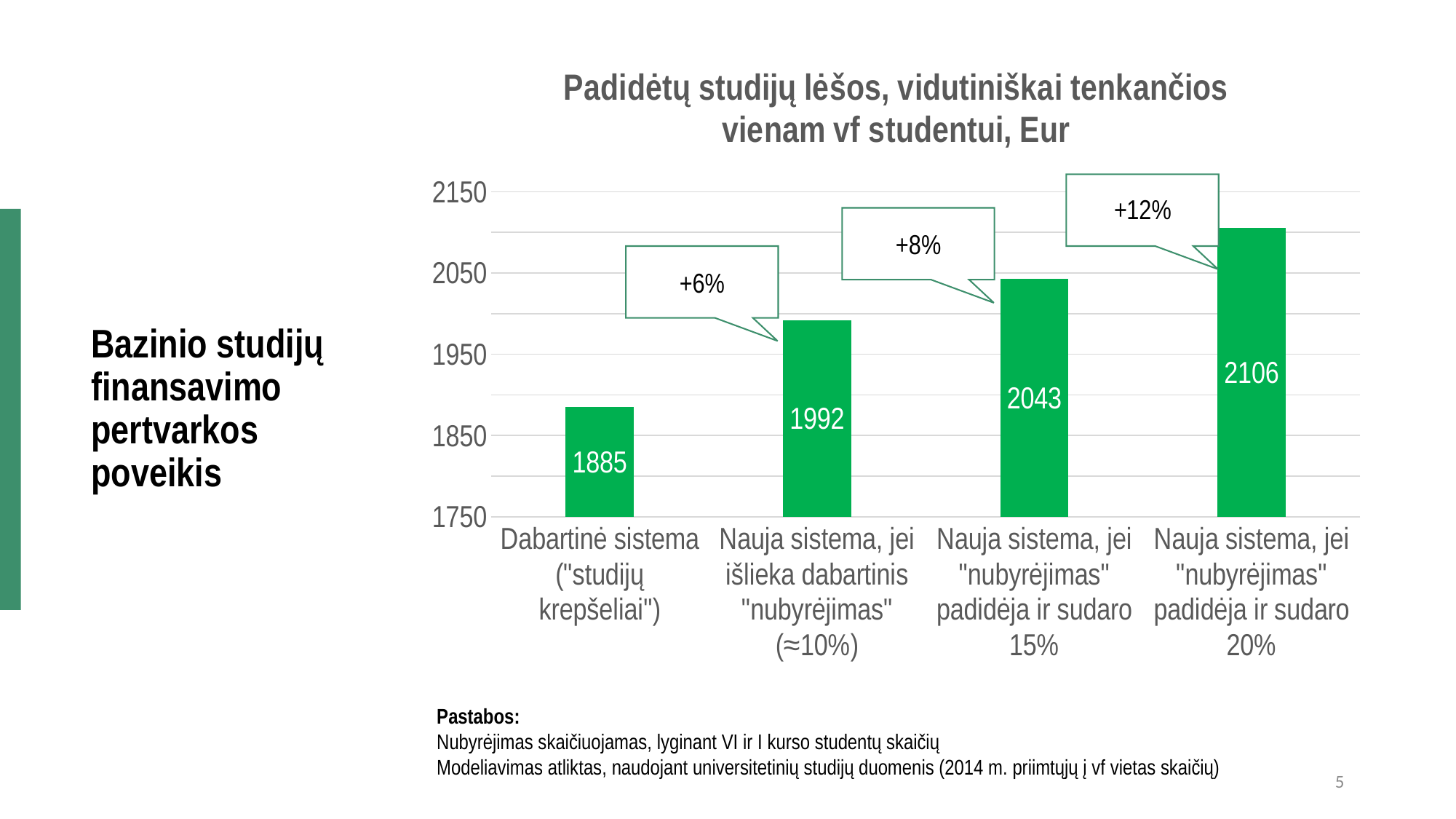
What percentage increase is shown in the callout above the bar for "Nauja sistema, jei "nubyrėjimas" padidėja ir sudaro 15%"? +8% Which category has the lowest value? Dabartinė sistema ("studijų krepšeliai") What is the value for "Nauja sistema, jei išlieka dabartinis "nubyrėjimas" (≈10%)"? 1992 How many categories are shown on the chart? 4 Do the values rise or fall from left to right along the x axis? rise What kind of chart is shown on the slide? bar chart Which category has the highest value? Nauja sistema, jei "nubyrėjimas" padidėja ir sudaro 20% Which is larger: the value for "Nauja sistema, jei išlieka dabartinis "nubyrėjimas" (≈10%)" or "Nauja sistema, jei "nubyrėjimas" padidėja ir sudaro 15%"? Nauja sistema, jei "nubyrėjimas" padidėja ir sudaro 15% Is the value for "Dabartinė sistema ("studijų krepšeliai")" greater or less than 1950? less What is the difference between the value for "Nauja sistema, jei "nubyrėjimas" padidėja ir sudaro 15%" and "Dabartinė sistema ("studijų krepšeliai")"? 158 What is the value for "Nauja sistema, jei "nubyrėjimas" padidėja ir sudaro 20%"? 2106 What is the value for "Dabartinė sistema ("studijų krepšeliai")"? 1885